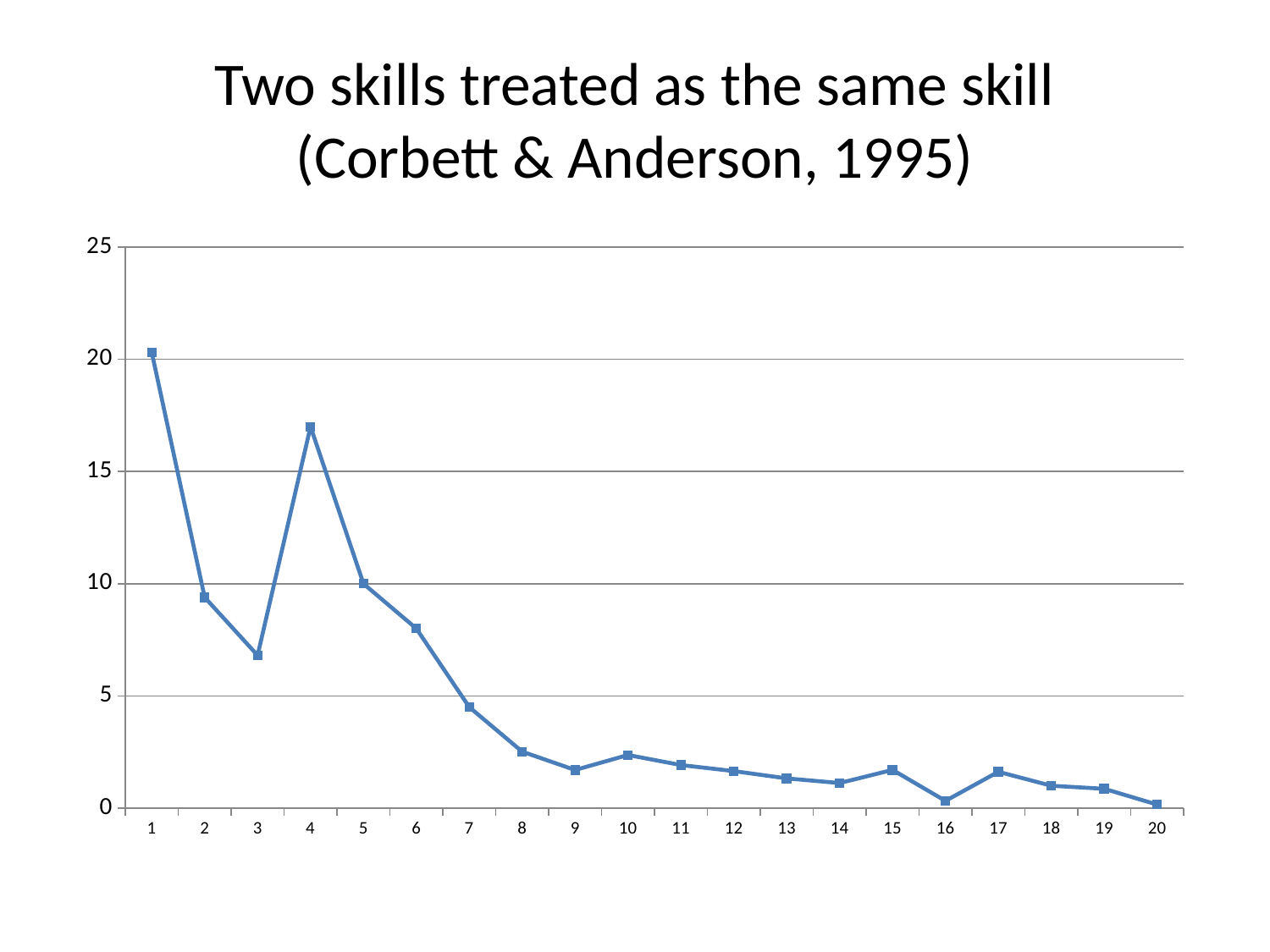
What is the title of the slide containing the chart? Two skills treated as the same skill (Corbett & Anderson, 1995) Is the value at point 3 greater or less than 10? less Is the value at point 4 greater or less than 15? greater What kind of chart is shown on the slide? line chart Which has the larger value, point 4 or point 5? point 4 Is the value at point 8 greater or less than 5? less Do the values generally rise or fall from point 1 to point 20? fall Which has the larger value, point 2 or point 3? point 2 Which x-axis point has the highest value? 1 How many data points are plotted along the x axis? 20